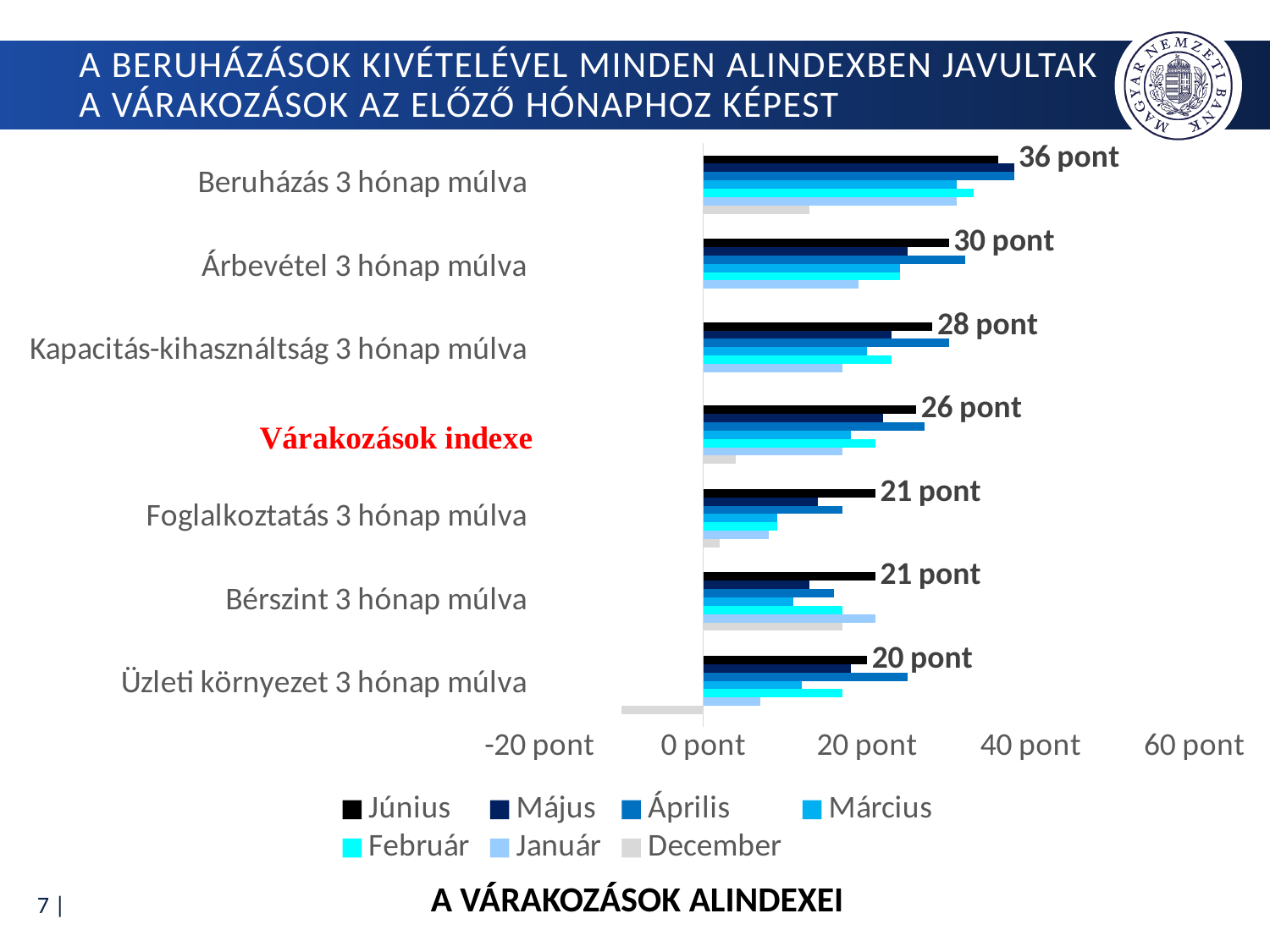
Is the December value for Üzleti környezet 3 hónap múlva greater or less than 0 pont? less Which category has the lowest Június value? Üzleti környezet 3 hónap múlva How many categories are shown on the chart? 7 What is the Június value for Várakozások indexe? 26 pont What is the Június value for Beruházás 3 hónap múlva? 36 pont What is the Június value for Árbevétel 3 hónap múlva? 30 pont What kind of chart is shown on the slide? bar chart Which category has the highest Június value? Beruházás 3 hónap múlva Which has the larger Június value: Árbevétel 3 hónap múlva or Kapacitás-kihasználtság 3 hónap múlva? Árbevétel 3 hónap múlva How many series does the legend list? 7 What is the Június value for Üzleti környezet 3 hónap múlva? 20 pont What is the difference between the Június values for Beruházás 3 hónap múlva and Üzleti környezet 3 hónap múlva? 16 pont